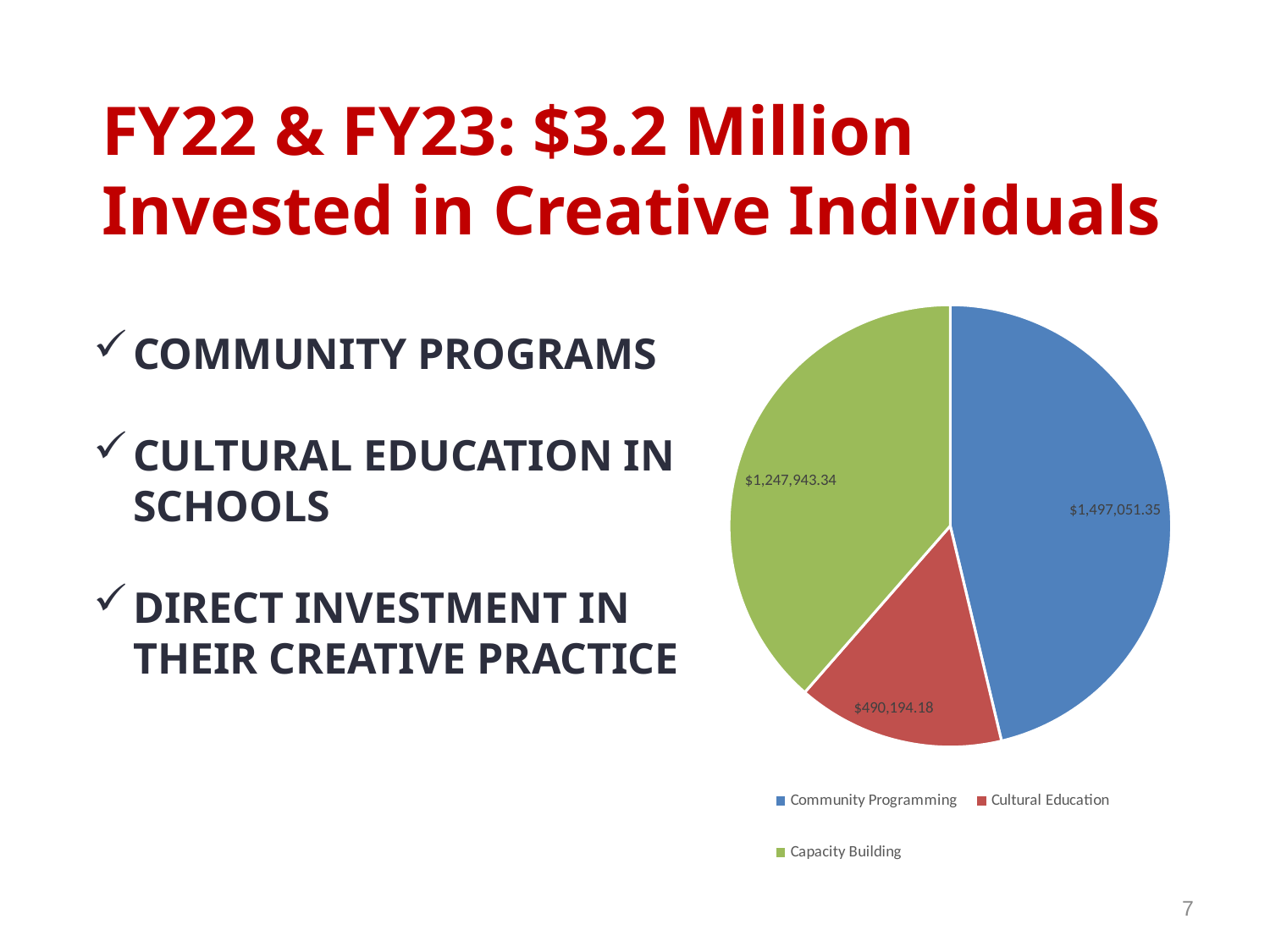
Which category has the smallest slice in the pie chart? Cultural Education What value is shown for the Cultural Education slice of the pie chart? $490,194.18 Which colour represents Capacity Building in the pie chart? Green What is the total of all three slices in the pie chart? $3,235,188.87 What value is shown for the Capacity Building slice of the pie chart? $1,247,943.34 What is the difference between the Community Programming and Capacity Building values in the pie chart? $249,108.01 What type of chart is shown on the slide? Pie chart How many slices does the pie chart have? 3 What is the difference between the Capacity Building and Cultural Education values in the pie chart? $757,749.16 What value is shown for the Community Programming slice of the pie chart? $1,497,051.35 Which is larger in the pie chart, Capacity Building or Cultural Education? Capacity Building Which category has the largest slice in the pie chart? Community Programming